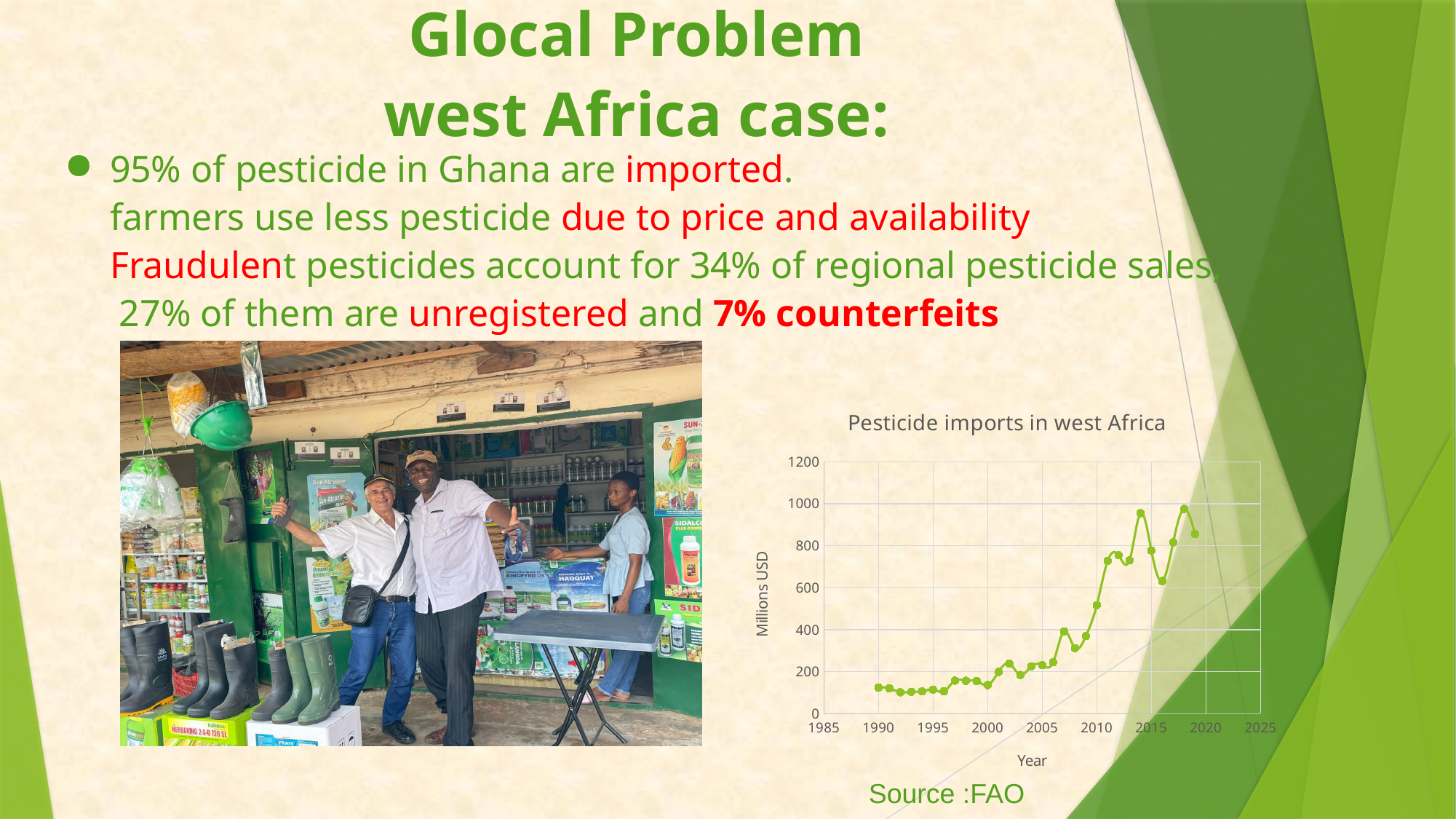
Which year has the larger value in the chart, 1995 or 2012? 2012 What is the label of the vertical axis of the chart? Millions USD What is the title of the chart on the slide? Pesticide imports in west Africa Overall, do pesticide imports in west Africa rise or fall from 1990 to 2019 in the chart? rise Is the value for 2018 in the chart greater or less than 800? greater Is the value for 2014 in the chart greater or less than 800? greater Is the value for 1990 in the chart greater or less than 200? less What kind of chart is shown on the slide? line chart Which year has the larger value in the chart, 2016 or 2018? 2018